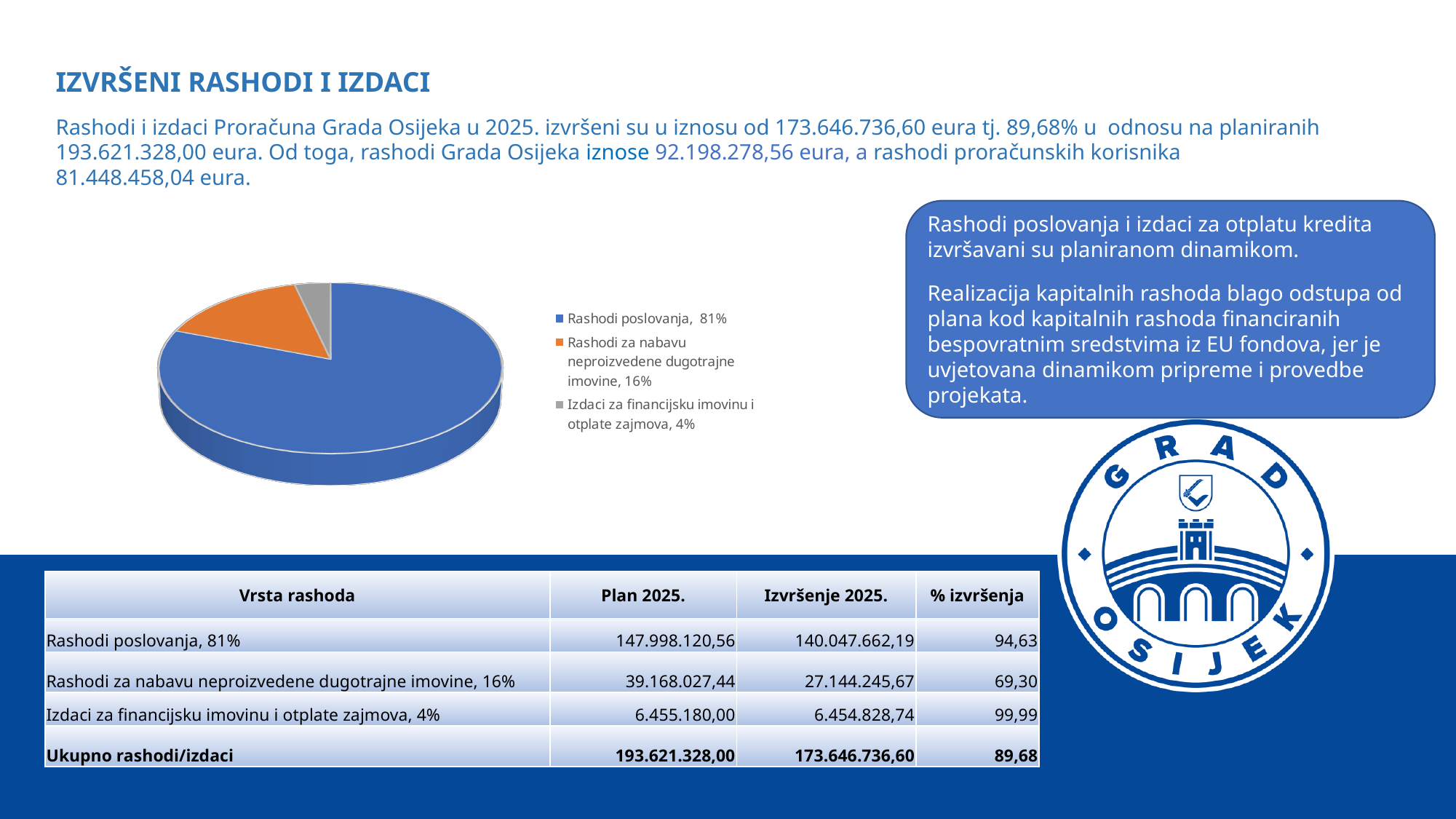
What kind of chart is shown on the slide? Pie chart What colour is the slice for "Rashodi poslovanja" in the pie chart? Blue By how many percentage points does the share of "Rashodi poslovanja" exceed the share of "Rashodi za nabavu neproizvedene dugotrajne imovine" in the pie chart? 65 percentage points Which category has the smallest slice of the pie? Izdaci za financijsku imovinu i otplate zajmova Which category has the largest slice of the pie? Rashodi poslovanja How many entries does the legend of the pie chart list? 3 Which is larger in the pie chart: the share for "Rashodi za nabavu neproizvedene dugotrajne imovine" or the share for "Izdaci za financijsku imovinu i otplate zajmova"? Rashodi za nabavu neproizvedene dugotrajne imovine What share of the pie does "Izdaci za financijsku imovinu i otplate zajmova" represent? 4% What share of the pie does "Rashodi za nabavu neproizvedene dugotrajne imovine" represent? 16% What colour is the slice for "Rashodi za nabavu neproizvedene dugotrajne imovine" in the pie chart? Orange How many slices does the pie chart have? 3 What share of the pie does "Rashodi poslovanja" represent? 81%